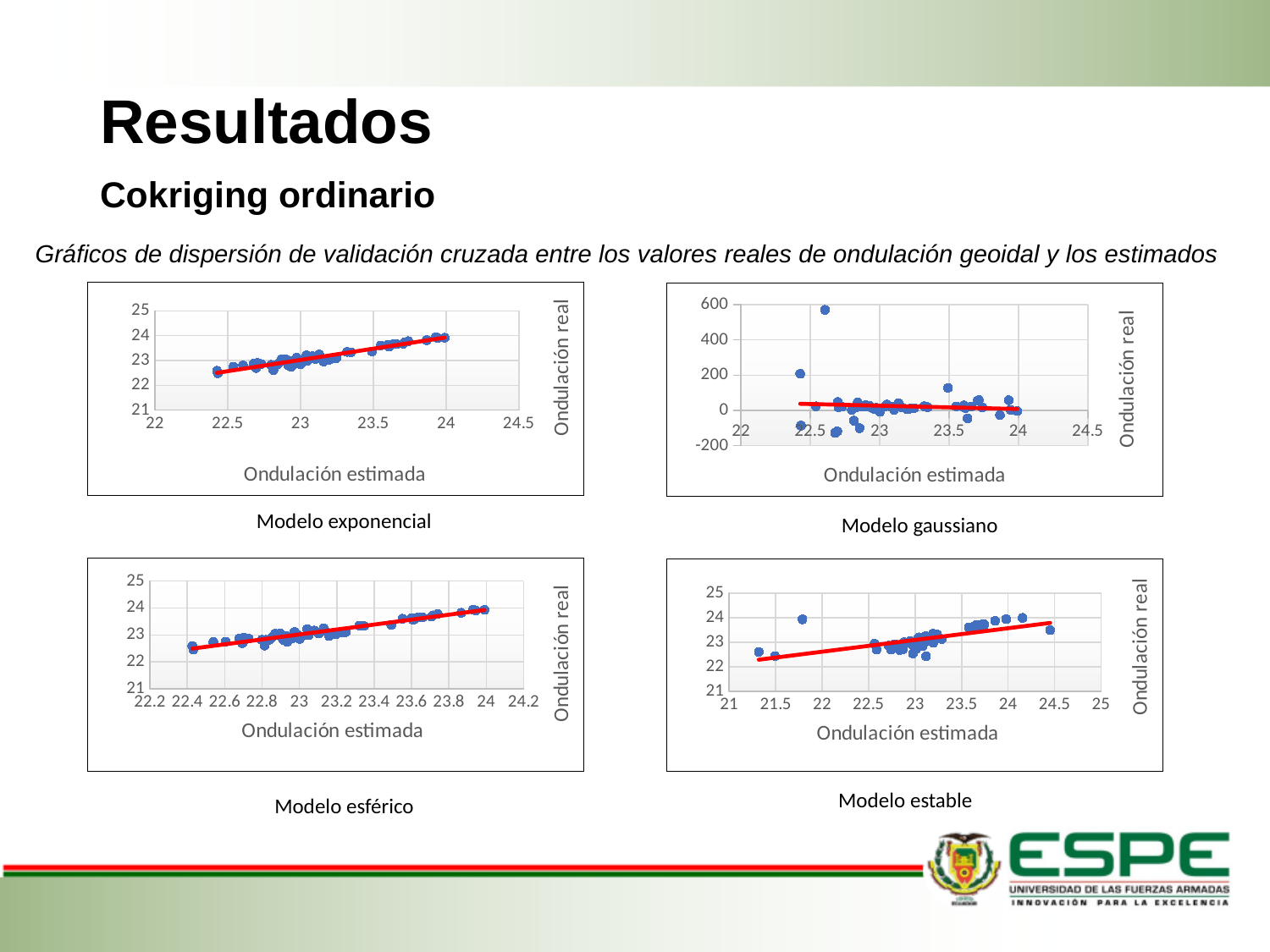
What is the title of the x axis in the Modelo esférico chart? Ondulación estimada In the Modelo exponencial chart, is the y value of the leftmost point greater or less than 22? greater In the Modelo gaussiano chart, does the red trend line rise or fall along the x axis? fall In the Modelo exponencial chart, do the plotted values rise or fall as the estimated undulation increases along the x axis? rise How many charts are shown on the slide? 4 Which of the four charts has the largest maximum value on its y axis? Modelo gaussiano In the Modelo estable chart, does the red trend line rise or fall along the x axis? rise What is the highest tick value on the y axis of the Modelo gaussiano chart? 600 What kind of chart is the Modelo exponencial chart? scatter chart In the Modelo estable chart, is the y value of the isolated point near x = 21.8 greater or less than 23? greater In the Modelo gaussiano chart, is the y value of the highest point greater or less than 400? greater